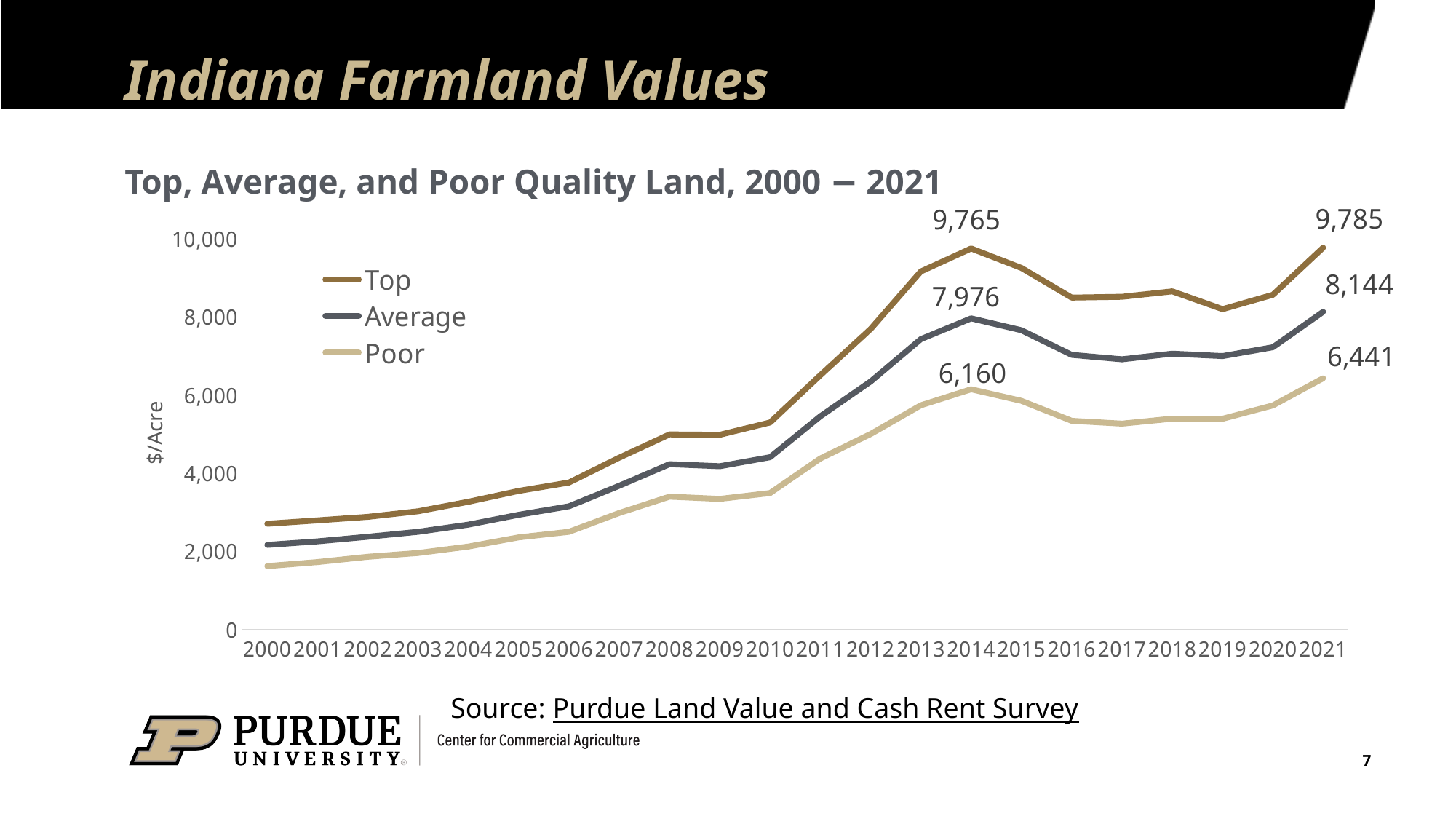
What kind of chart is shown on the slide? line chart Which series has the highest value in 2021? Top What is the value of Average quality land in 2014? 7,976 Which series has the lowest value in 2014? Poor What is the value of Poor quality land in 2021? 6,441 What is the value of Top quality land in 2021? 9,785 What is the label on the vertical axis? $/Acre How many series does the legend list? 3 What is the value of Top quality land in 2014? 9,765 What is the difference between the Top quality land value in 2021 and in 2014? 20 What is the difference between the Top and Poor quality land values in 2021? 3,344 Is the value for Average quality land in 2000 greater or less than 4,000? less